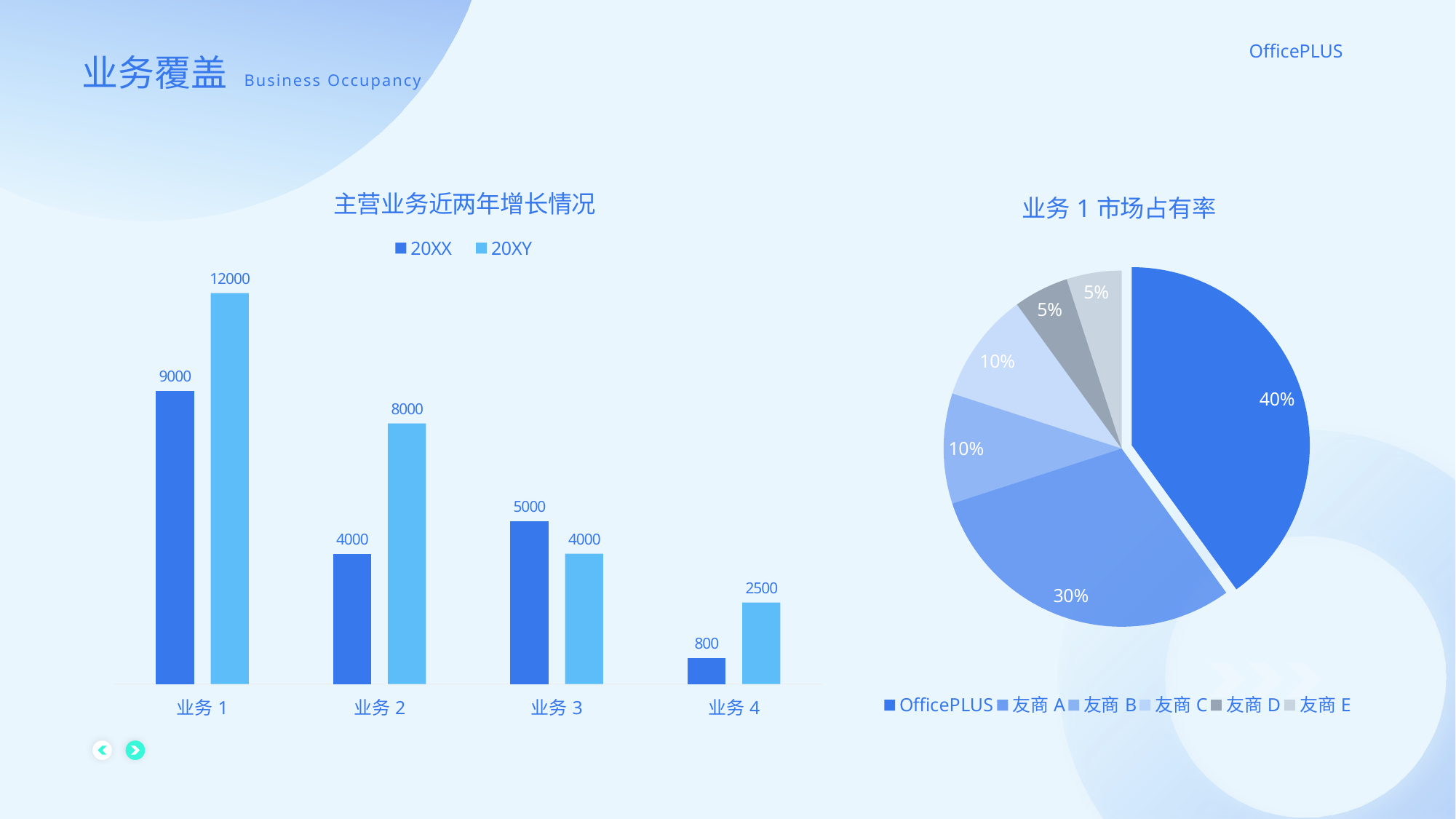
In the chart titled 主营业务近两年增长情况, how many categories are shown on the x axis? 4 In the chart titled 主营业务近两年增长情况, how many series does the legend list? 2 In the chart titled 业务 1 市场占有率, how many entries does the legend list? 6 In the chart titled 主营业务近两年增长情况, for 业务 3, which series has the larger value, 20XX or 20XY? 20XX In the chart titled 主营业务近两年增长情况, what is the value for 业务 4 in the 20XX series? 800 In the chart titled 业务 1 市场占有率, what share does OfficePLUS hold? 40% In the chart titled 主营业务近两年增长情况, which category has the highest 20XX value? 业务 1 What kind of chart is the one titled 主营业务近两年增长情况? Bar chart In the chart titled 主营业务近两年增长情况, what is the value for 业务 1 in the 20XY series? 12000 In the chart titled 主营业务近两年增长情况, what is the difference between the 20XY and 20XX values for 业务 2? 4000 In the chart titled 主营业务近两年增长情况, which category has the lowest 20XY value? 业务 4 In the chart titled 业务 1 市场占有率, what share does 友商 A hold? 30%